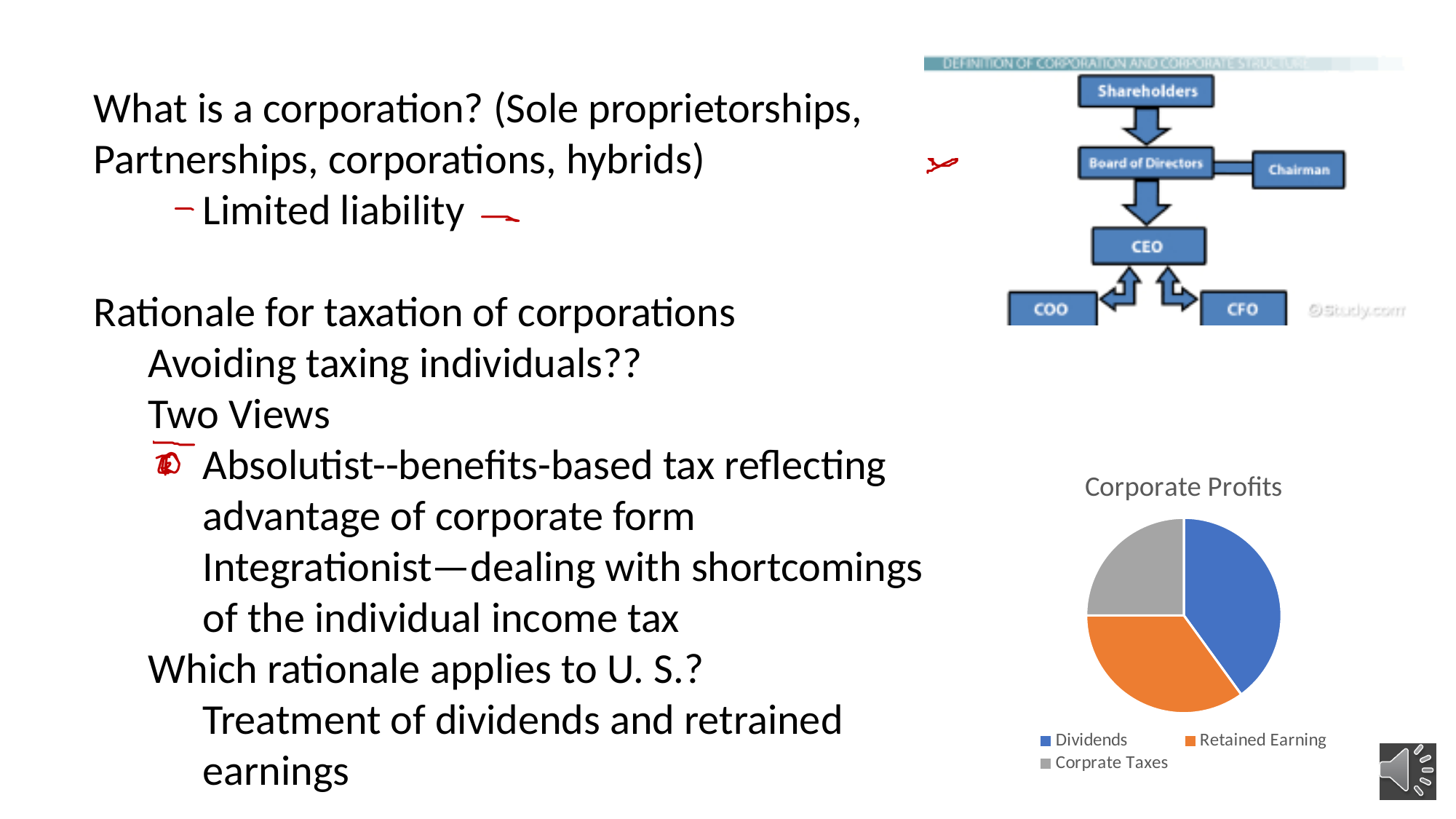
What kind of chart is the "Corporate Profits" chart? pie chart What is the title of the pie chart on the slide? Corporate Profits In the "Corporate Profits" pie chart, which is larger: Retained Earning or Corprate Taxes? Retained Earning What colour is the Dividends slice in the "Corporate Profits" pie chart? blue Which slice of the "Corporate Profits" pie chart is the smallest? Corprate Taxes How many slices does the "Corporate Profits" pie chart have? 3 In the "Corporate Profits" pie chart, which is larger: Dividends or Corprate Taxes? Dividends How many entries does the legend of the "Corporate Profits" chart list? 3